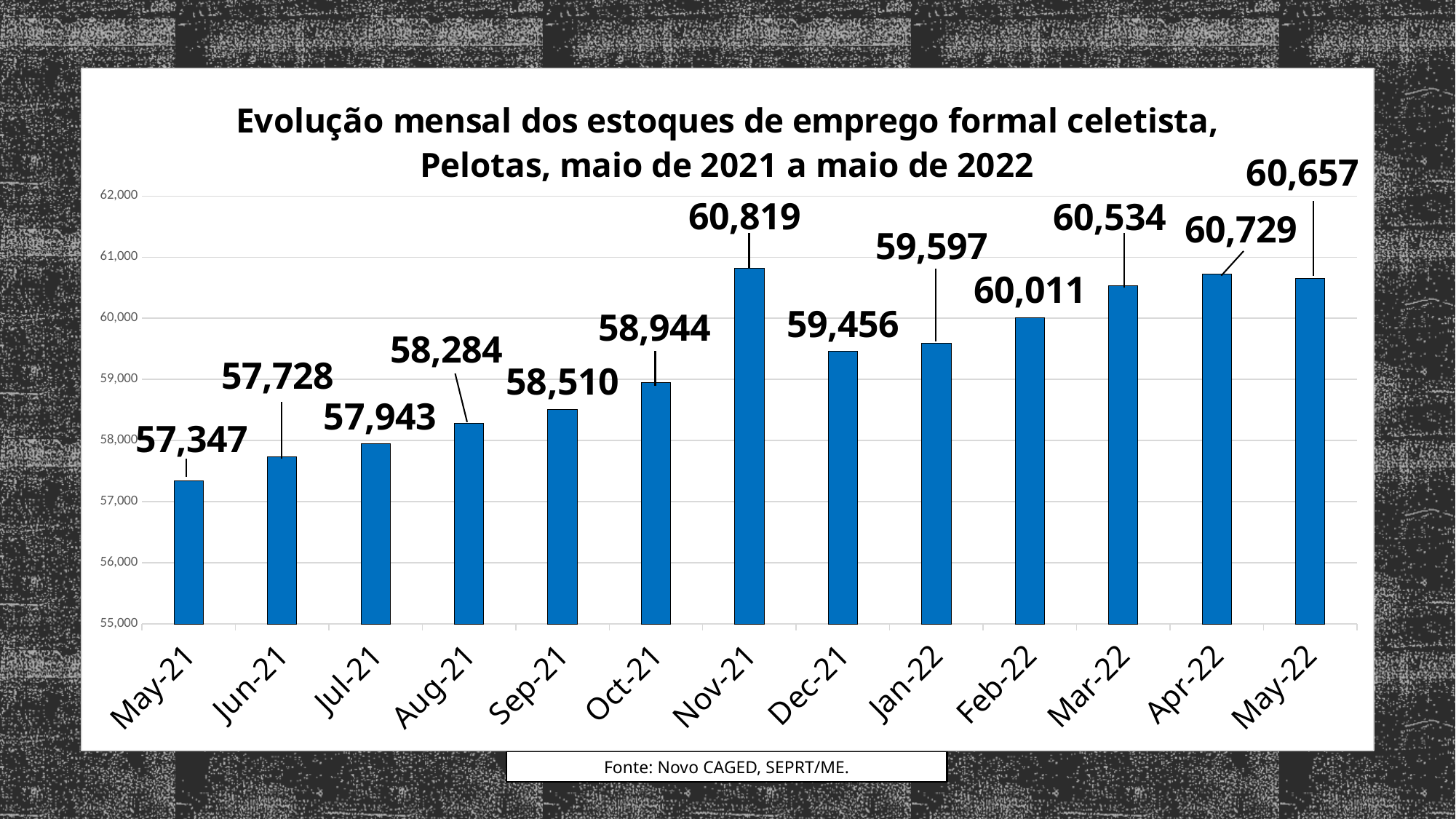
What is the value for Nov-21? 60,819 What is the difference between the values for May-22 and May-21? 3,310 What is the difference between the values for Nov-21 and Oct-21? 1,875 How many months are shown on the x axis? 13 Which is larger, the value for Apr-22 or the value for May-22? Apr-22 Which month has the lowest value? May-21 Which month has the highest value? Nov-21 Is the value for Dec-21 greater or less than 60,000? less What is the source cited below the chart? Novo CAGED, SEPRT/ME. What is the value for Feb-22? 60,011 What kind of chart is shown on the slide? bar chart What is the value for May-21? 57,347